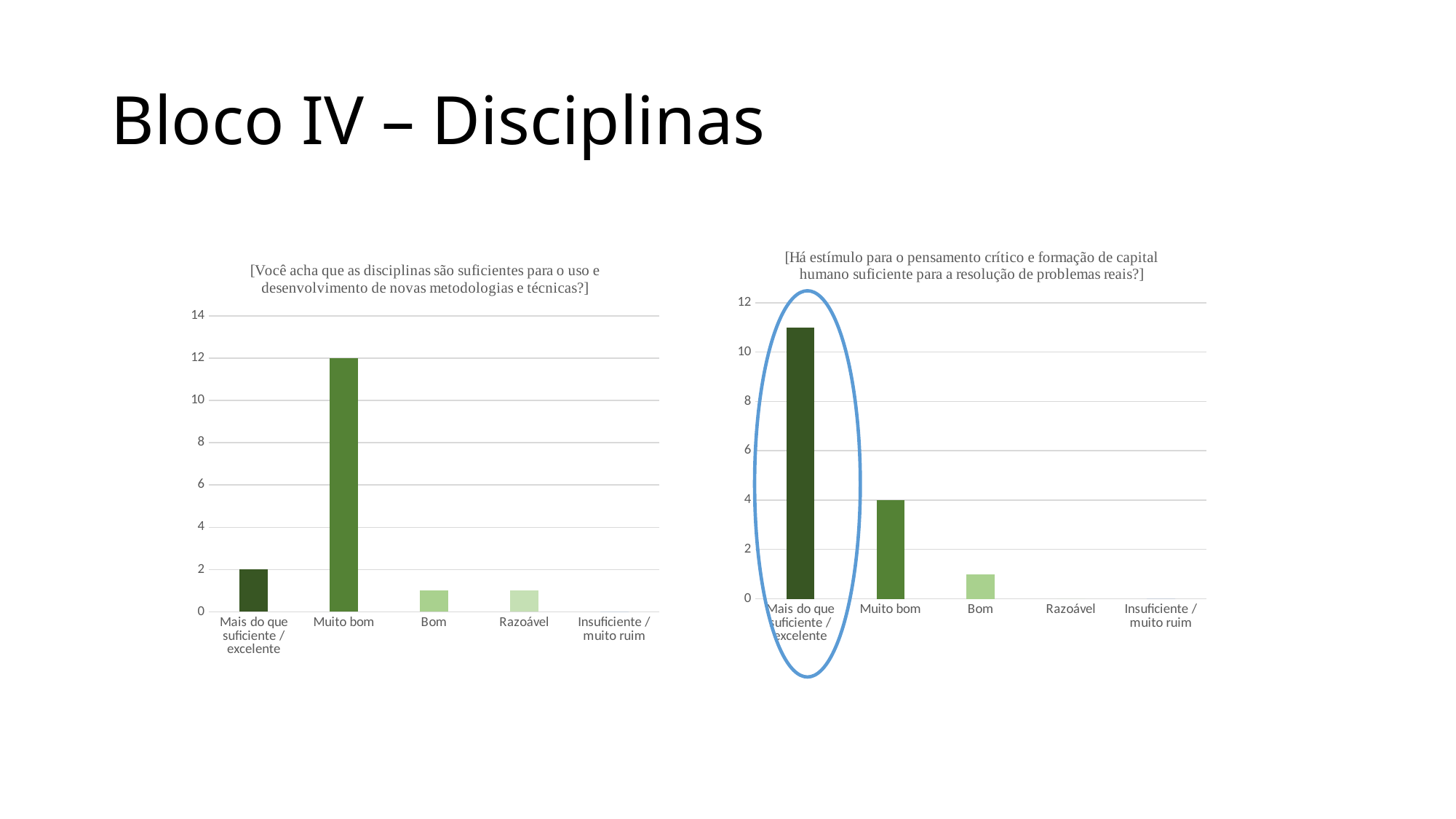
In the left chart ([Você acha que as disciplinas são suficientes...]), what is the value for Muito bom? 12 In the right chart ([Há estímulo para o pensamento crítico...]), which is larger, the value for Mais do que suficiente / excelente or the value for Muito bom? Mais do que suficiente / excelente In the left chart ([Você acha que as disciplinas são suficientes...]), which category has the lowest value? Insuficiente / muito ruim In the right chart ([Há estímulo para o pensamento crítico...]), what is the value for Muito bom? 4 In the left chart ([Você acha que as disciplinas são suficientes...]), what is the difference between the values for Muito bom and Mais do que suficiente / excelente? 10 In the left chart ([Você acha que as disciplinas são suficientes...]), what is the value for Mais do que suficiente / excelente? 2 In the right chart ([Há estímulo para o pensamento crítico...]), is the value for Mais do que suficiente / excelente greater or less than 10? greater In the right chart ([Há estímulo para o pensamento crítico...]), which category has the highest value? Mais do que suficiente / excelente In the right chart ([Há estímulo para o pensamento crítico...]), which bar is circled by the blue ellipse? Mais do que suficiente / excelente In the left chart ([Você acha que as disciplinas são suficientes...]), is the value for Bom greater or less than 2? less In the left chart ([Você acha que as disciplinas são suficientes...]), which category has the highest value? Muito bom How many categories are shown on the x axis of the left chart ([Você acha que as disciplinas são suficientes...])? 5